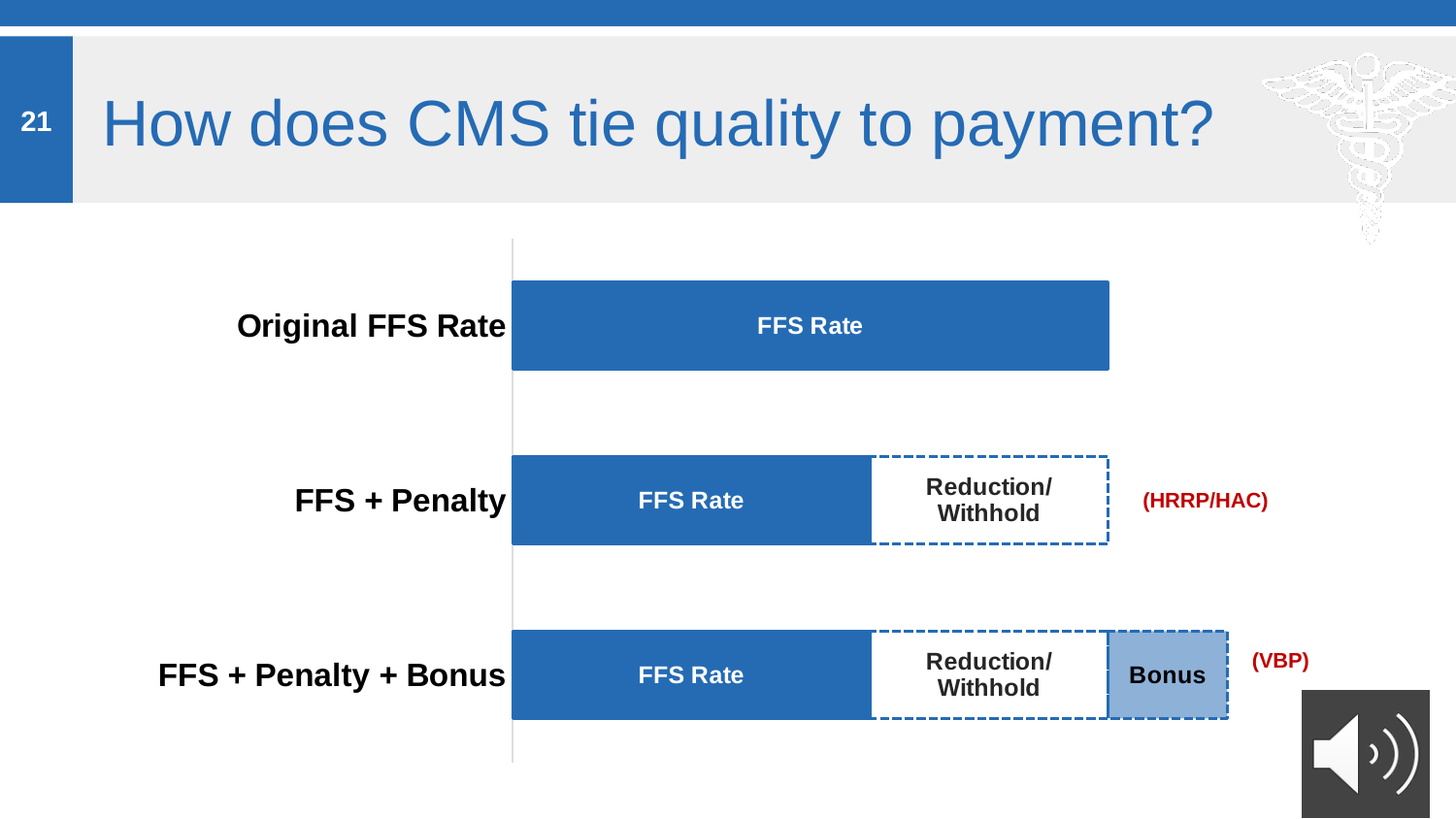
What is the label of the segment that appears only in the 'FFS + Penalty + Bonus' bar? Bonus Which bar consists of only a single segment? Original FFS Rate How many categories (bars) does the chart show? 3 What is the label of the top bar in the chart? Original FFS Rate Which bar has the most segments? FFS + Penalty + Bonus Which program annotation is shown in red next to the 'FFS + Penalty + Bonus' bar? (VBP) What kind of chart is shown on the slide? Bar chart How many segments make up the 'FFS + Penalty' bar? 2 How many segments make up the 'FFS + Penalty + Bonus' bar? 3 Which program annotation is shown in red next to the 'FFS + Penalty' bar? (HRRP/HAC) What is the label of the bottom bar in the chart? FFS + Penalty + Bonus What label is printed on the dashed-outline segment in the 'FFS + Penalty' bar? Reduction/ Withhold